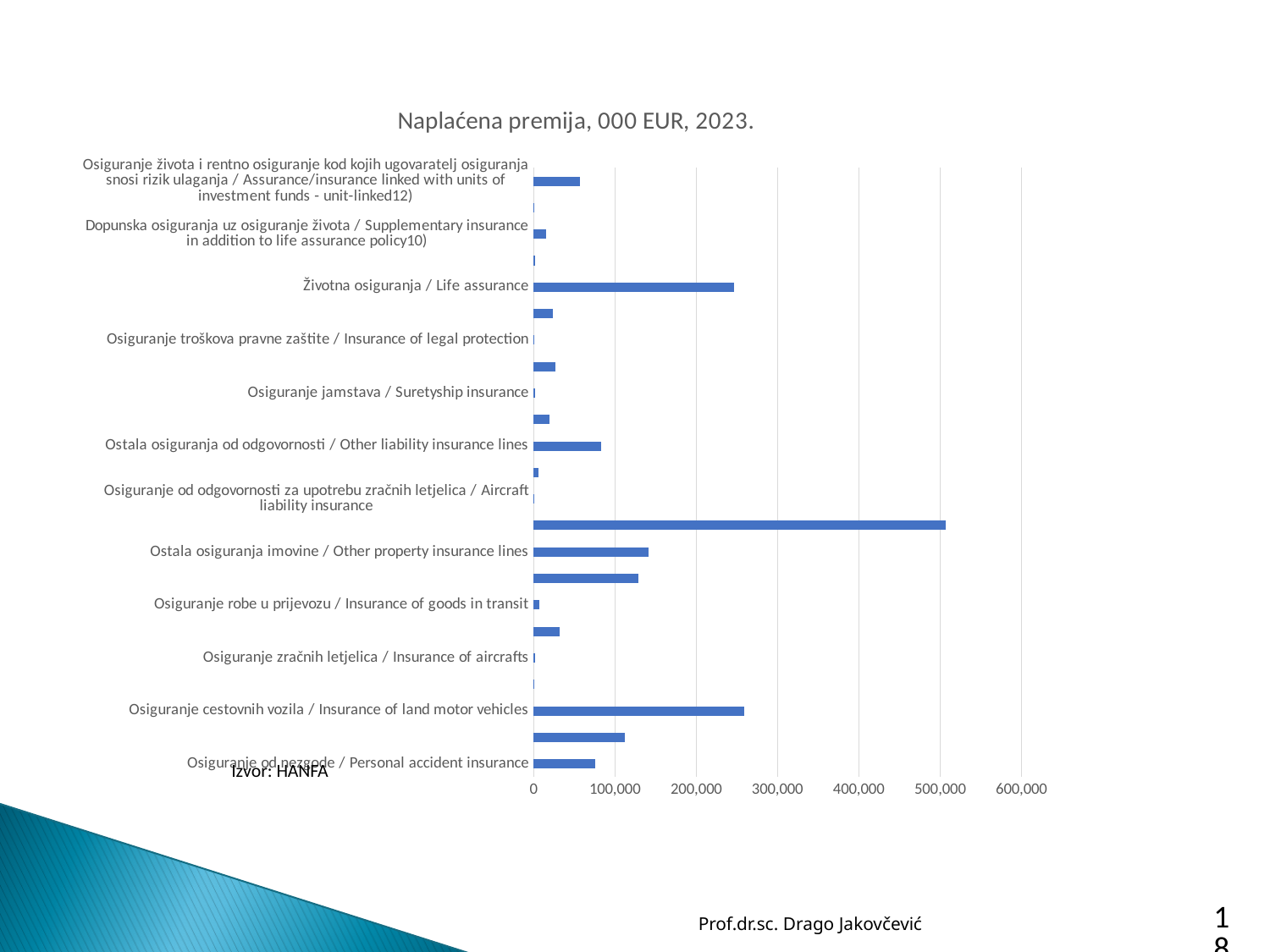
Is the value for Životna osiguranja / Life assurance greater or less than 300,000? less Which is larger, the value for Životna osiguranja / Life assurance or the value for Ostala osiguranja imovine / Other property insurance lines? Životna osiguranja / Life assurance Is the value for Ostala osiguranja imovine / Other property insurance lines greater or less than 100,000? greater What source is cited below the chart? HANFA Is the value for Osiguranje od nezgode / Personal accident insurance greater or less than 100,000? less What is the title of the chart? Naplaćena premija, 000 EUR, 2023. What kind of chart is shown on the slide? bar chart Which is larger, the value for Osiguranje cestovnih vozila / Insurance of land motor vehicles or the value for Osiguranje od nezgode / Personal accident insurance? Osiguranje cestovnih vozila / Insurance of land motor vehicles